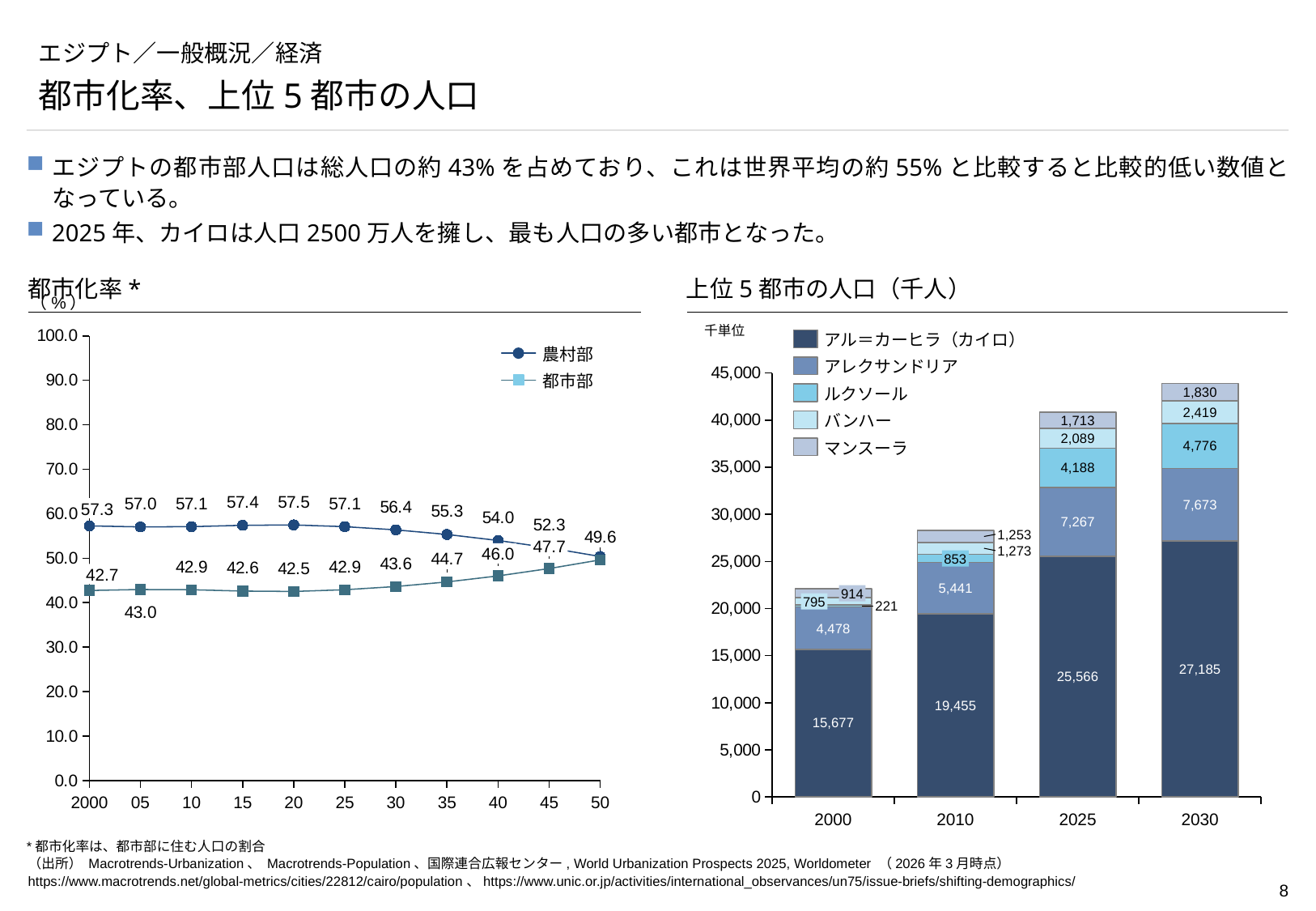
In the 都市化率 chart on the left, does the 都市部 line rise or fall from 2020 to 2045? rise In the 上位5都市の人口 chart on the right, what is the total of the stacked bar for 2025? 40,823 How many series does the legend of the 都市化率 chart on the left list? 2 What kind of chart is the 上位5都市の人口 chart on the right? stacked bar chart What kind of chart is the 都市化率 chart on the left? line chart In the 上位5都市の人口 chart on the right, how many years are shown on the x axis? 4 In the 都市化率 chart on the left, what is the value for 都市部 in 2040? 46.0 In the 上位5都市の人口 chart on the right, what is the value for ルクソール in 2030? 4,776 In the 都市化率 chart on the left, what is the value for 農村部 in 2000? 57.3 In the 上位5都市の人口 chart on the right, what is the value for アル＝カーヒラ（カイロ） in 2025? 25,566 In the 都市化率 chart on the left, what is the difference between the 農村部 values in 2020 and 2045? 5.2 How many series does the legend of the 上位5都市の人口 chart on the right list? 5